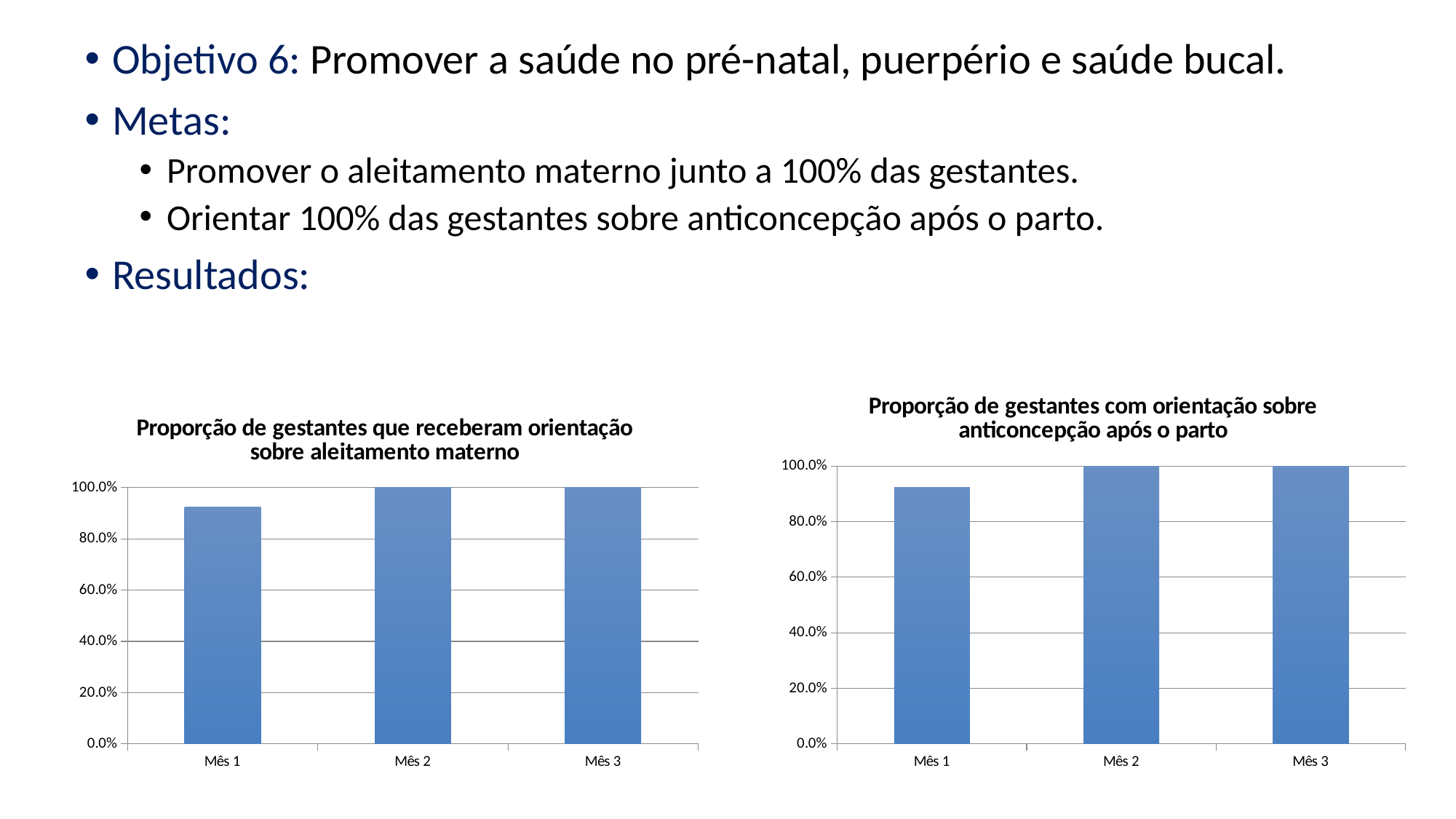
In the right chart (anticoncepção após o parto), is the value for Mês 1 greater or less than 80.0%? greater How many categories are shown on the x axis of the left chart (aleitamento materno)? 3 In the left chart (aleitamento materno), is the value for Mês 1 greater or less than 80.0%? greater In the right chart (anticoncepção após o parto), which is larger, the value for Mês 1 or the value for Mês 3? Mês 3 In the left chart (aleitamento materno), which is larger, the value for Mês 1 or the value for Mês 2? Mês 2 In the left chart (aleitamento materno), do the values rise or fall from Mês 1 to Mês 2? rise In the right chart (anticoncepção após o parto), which month has the lowest value? Mês 1 What kind of chart is the right chart (anticoncepção após o parto)? bar chart In the chart titled 'Proporção de gestantes com orientação sobre anticoncepção após o parto', what is the value for Mês 3? 100.0% In the chart titled 'Proporção de gestantes que receberam orientação sobre aleitamento materno', what is the value for Mês 2? 100.0% In the left chart (aleitamento materno), which month has the lowest value? Mês 1 How many charts are shown on the slide? 2